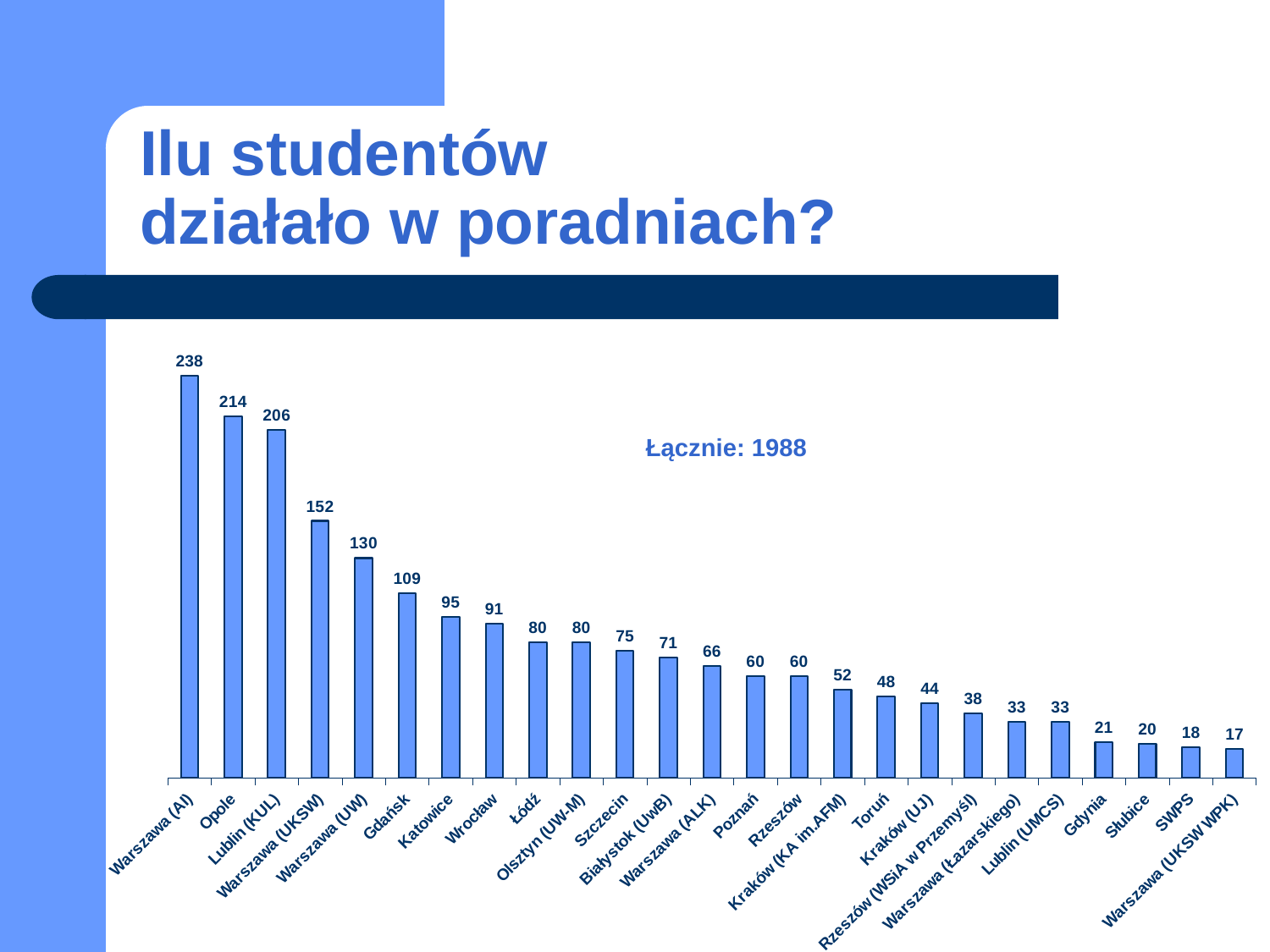
Which is larger, the value for Katowice or the value for Wrocław? Katowice What is the value for Toruń? 48 What total is stated on the chart next to 'Łącznie'? 1988 What is the value for Lublin (UMCS)? 33 What is the difference between the values for Warszawa (UKSW) and Warszawa (UW)? 22 Which category has the lowest value? Warszawa (UKSW WPK) What kind of chart is shown on the slide? bar chart How many students are shown for Warszawa (AI)? 238 Which category has the highest value? Warszawa (AI) What is the value for Gdańsk? 109 What is the difference between the values for Opole and Lublin (KUL)? 8 How many categories are shown in the chart? 25